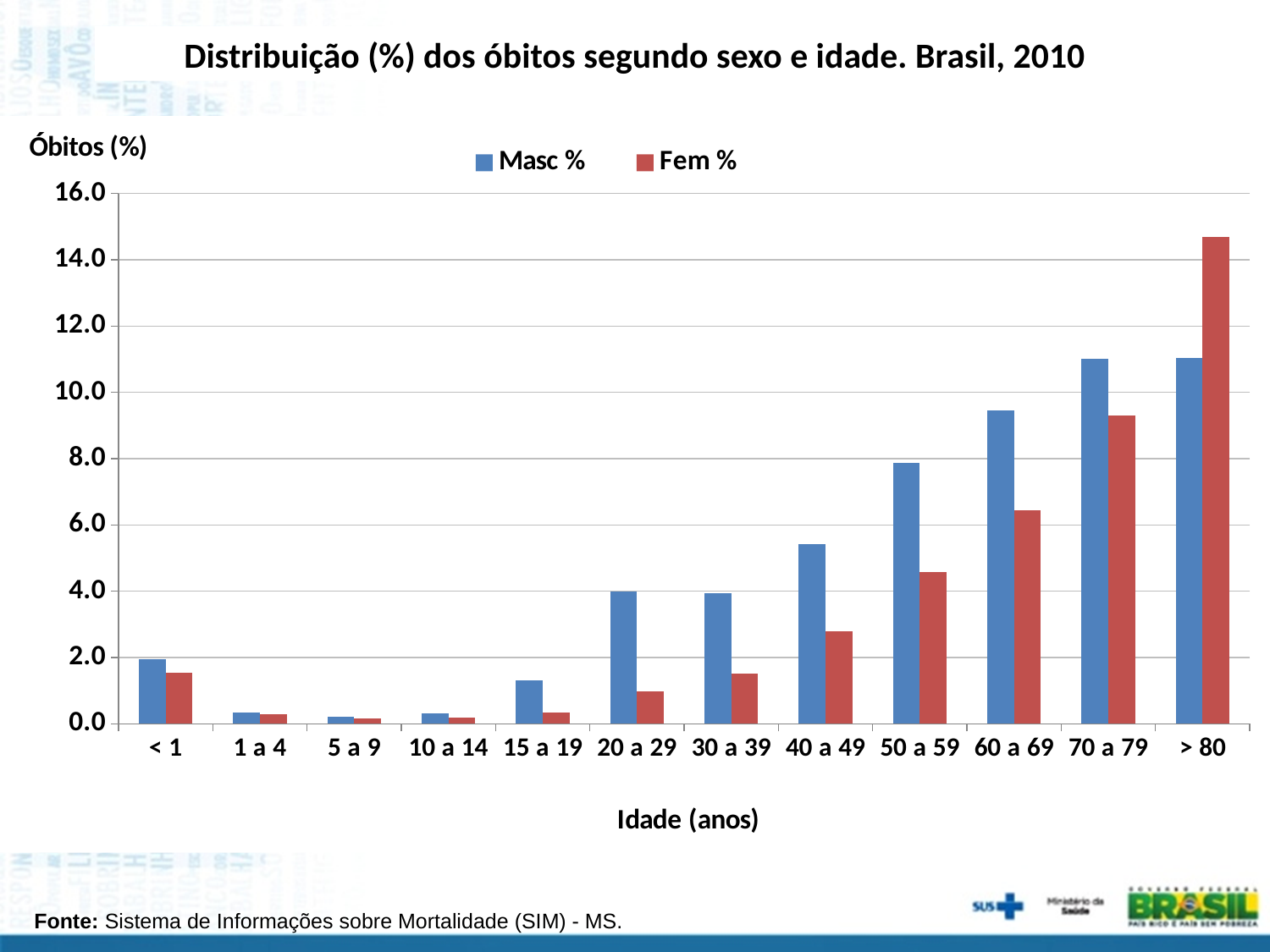
How many series does the legend list? 2 What is the title of the chart? Distribuição (%) dos óbitos segundo sexo e idade. Brasil, 2010 How many age categories are shown on the x axis? 12 Is the Fem % value for the > 80 age group greater or less than 14.0? greater Do the Fem % values rise or fall from the 20 a 29 age group to the > 80 age group? Rise Is the Fem % value for the 70 a 79 age group greater or less than 10.0? less Is the Masc % value for the 40 a 49 age group greater or less than 4.0? greater Which age group has the highest value for Fem %? > 80 For the 40 a 49 age group, which series has the larger value, Masc % or Fem %? Masc % For the > 80 age group, which series has the larger value, Masc % or Fem %? Fem % What kind of chart is shown on the slide? Bar chart